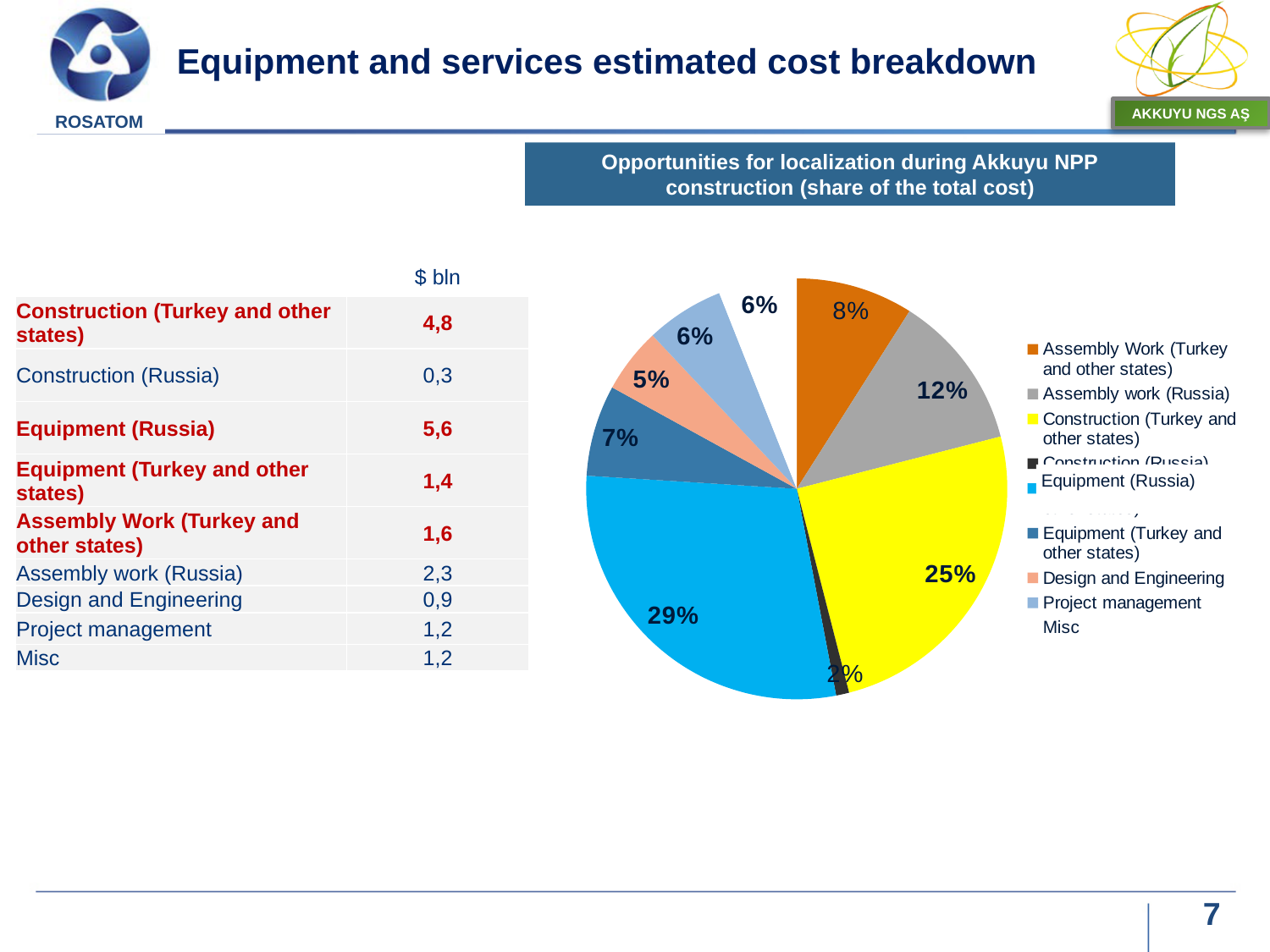
What share does Assembly work (Russia) have in the pie chart? 12% Which is larger in the pie chart: Assembly Work (Turkey and other states) or Equipment (Turkey and other states)? Assembly Work (Turkey and other states) Which category has the largest slice in the pie chart? Equipment (Russia) By how many percentage points does the Equipment (Russia) share exceed the Construction (Turkey and other states) share? 4 percentage points How many slices does the pie chart have? 9 What is the combined share of Assembly Work (Turkey and other states) and Assembly work (Russia) in the pie chart? 20% What share does Design and Engineering have in the pie chart? 5% What kind of chart is shown on the slide? Pie chart What is the title shown above the pie chart? Opportunities for localization during Akkuyu NPP construction (share of the total cost) What share of the total cost does Construction (Turkey and other states) represent in the pie chart? 25% What share of the total cost does Equipment (Russia) represent in the pie chart? 29% Which category has the smallest slice in the pie chart? Construction (Russia)